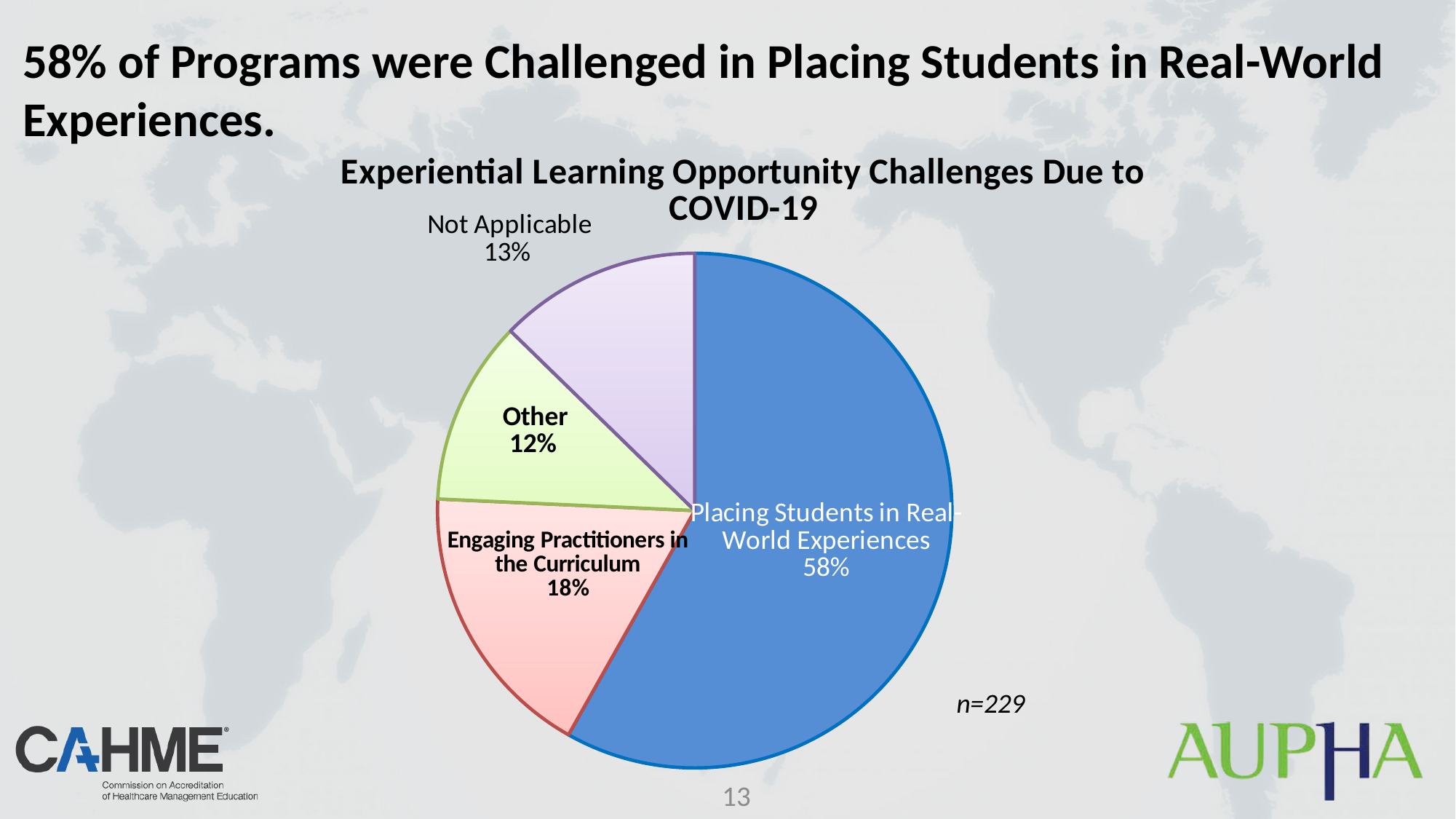
What is the title of the chart? Experiential Learning Opportunity Challenges Due to COVID-19 Which category has the smallest slice of the pie? Other What share of the pie does Placing Students in Real-World Experiences represent? 58% What percentage is shown for Engaging Practitioners in the Curriculum? 18% Which category has the largest slice of the pie? Placing Students in Real-World Experiences What is the difference in percentage points between Placing Students in Real-World Experiences and Engaging Practitioners in the Curriculum? 40 What kind of chart is shown on the slide? Pie chart What percentage is shown for the Other slice? 12% What sample size (n) is noted on the chart? n=229 What percentage is shown for Not Applicable? 13% How many slices does the pie chart have? 4 Which is larger: Engaging Practitioners in the Curriculum or Not Applicable? Engaging Practitioners in the Curriculum